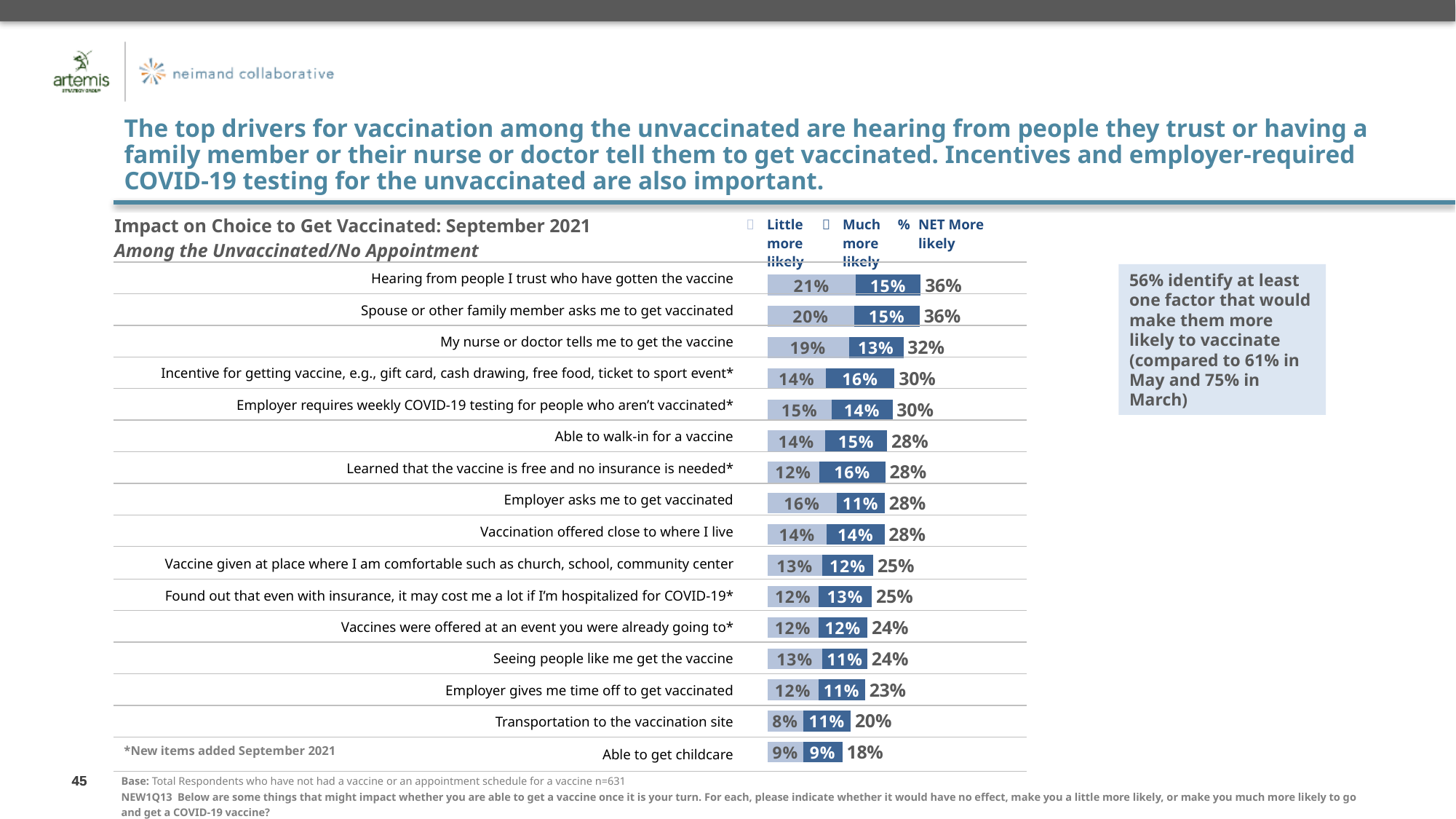
What is the "Much more likely" value for "My nurse or doctor tells me to get the vaccine"? 13% Which category has the highest "Little more likely" value? Hearing from people I trust who have gotten the vaccine What is the title of the chart? Impact on Choice to Get Vaccinated: September 2021 How many categories are shown in the chart? 16 What is the "Little more likely" value for "Employer asks me to get vaccinated"? 16% Which category has the lowest "Little more likely" value? Transportation to the vaccination site What kind of chart is shown on the slide? Stacked horizontal bar chart What is the difference between the NET More likely values for "Spouse or other family member asks me to get vaccinated" and "Able to get childcare"? 18% Which is larger: the "Much more likely" value for "Incentive for getting vaccine" or for "Employer gives me time off to get vaccinated"? Incentive for getting vaccine What is the total of the "Little more likely" and "Much more likely" values for "Transportation to the vaccination site"? 19% Which category has the lowest NET More likely value? Able to get childcare What is the NET More likely value for "Hearing from people I trust who have gotten the vaccine"? 36%